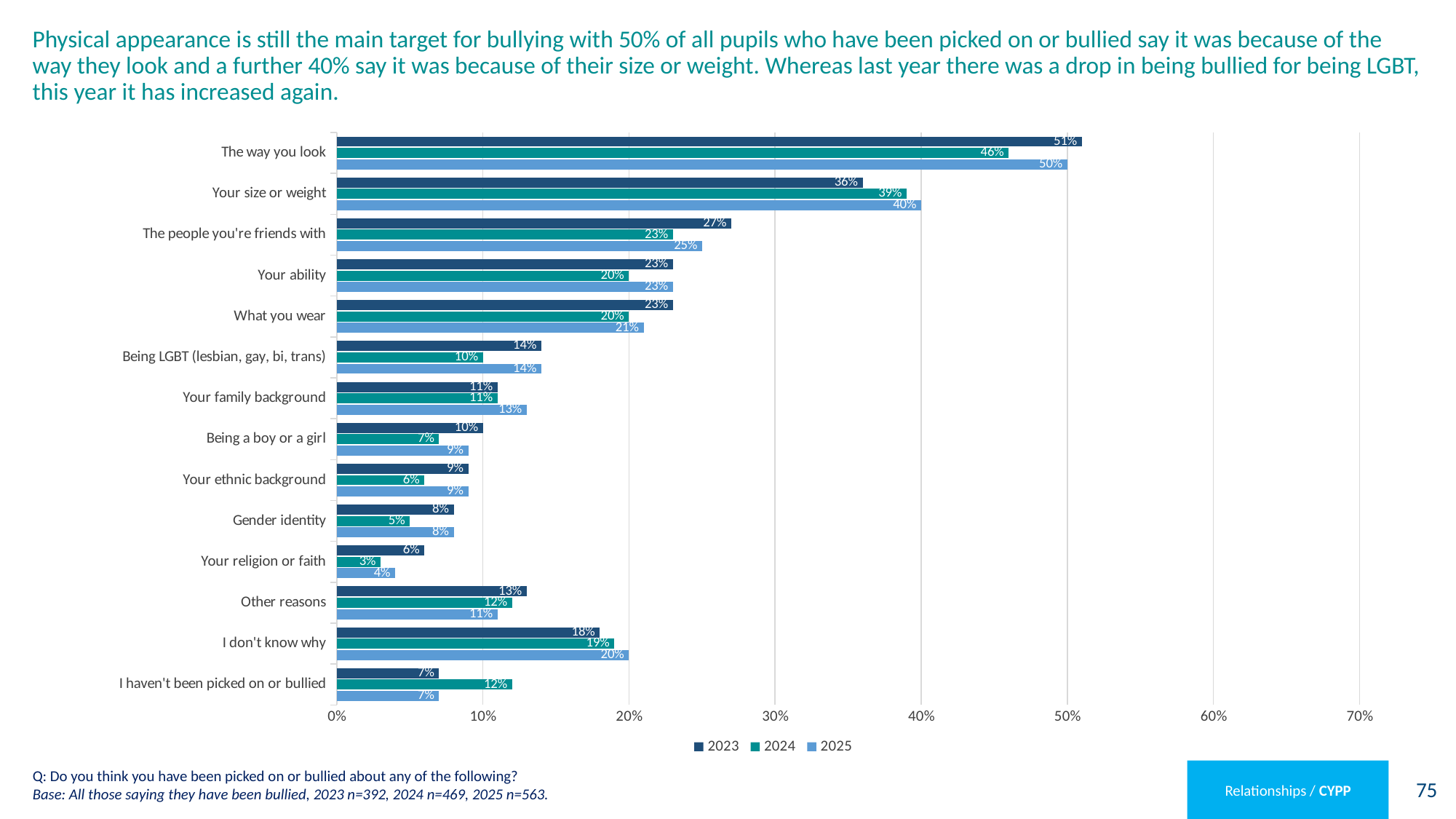
What is the 2023 value for 'Being LGBT (lesbian, gay, bi, trans)'? 14% What is the difference between the 2025 and 2024 values for 'Being LGBT (lesbian, gay, bi, trans)'? 4% How many series does the legend list? 3 What is the 2024 value for 'Your size or weight'? 39% What kind of chart is shown on the slide? Bar chart Is the 2023 value for 'Your size or weight' greater or less than 30%? greater Which years are listed in the chart legend? 2023, 2024, 2025 Which category has the highest 2023 value? The way you look Which is larger: the 2023 value for 'I don't know why' or the 2025 value for 'I don't know why'? 2025 What is the 2025 value for 'The way you look'? 50% Which category has the lowest 2024 value? Your religion or faith How many categories are shown on the chart? 14